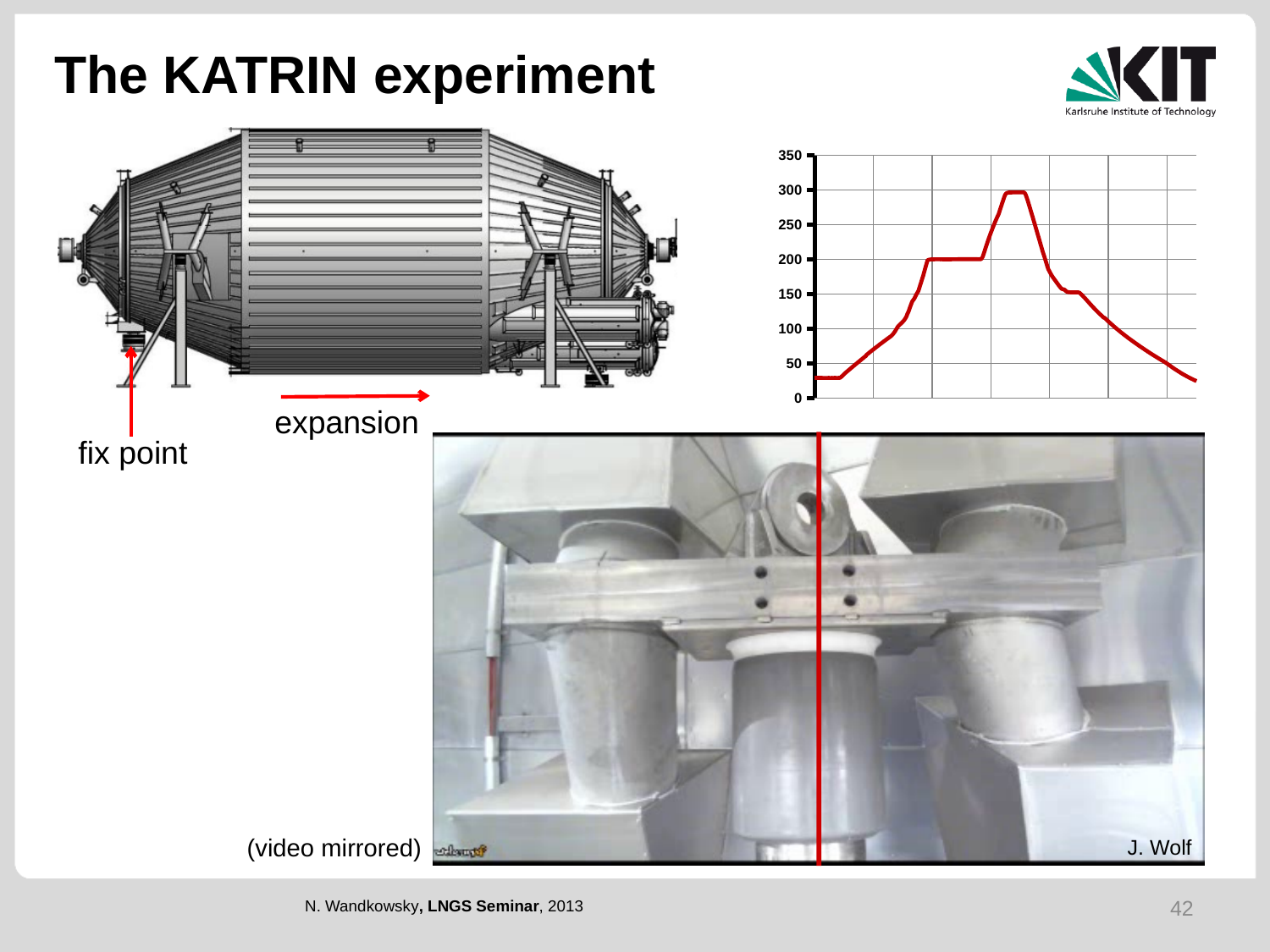
What kind of chart is shown at the top right of the slide? line chart In the line chart at the top right, is the value of the flat section before the peak greater or less than 150? greater In the line chart at the top right, is the value at the left end of the line greater or less than 50? less In the line chart at the top right, does the line rise or fall from the left end up to the peak? rise How many lines are plotted in the line chart at the top right? 1 In the line chart at the top right, is the value at the right end of the line greater or less than 100? less What is the highest value labelled on the y axis of the line chart at the top right? 350 What colour is the line in the chart at the top right of the slide? red In the line chart at the top right, does the line rise or fall from the peak to the right end? fall